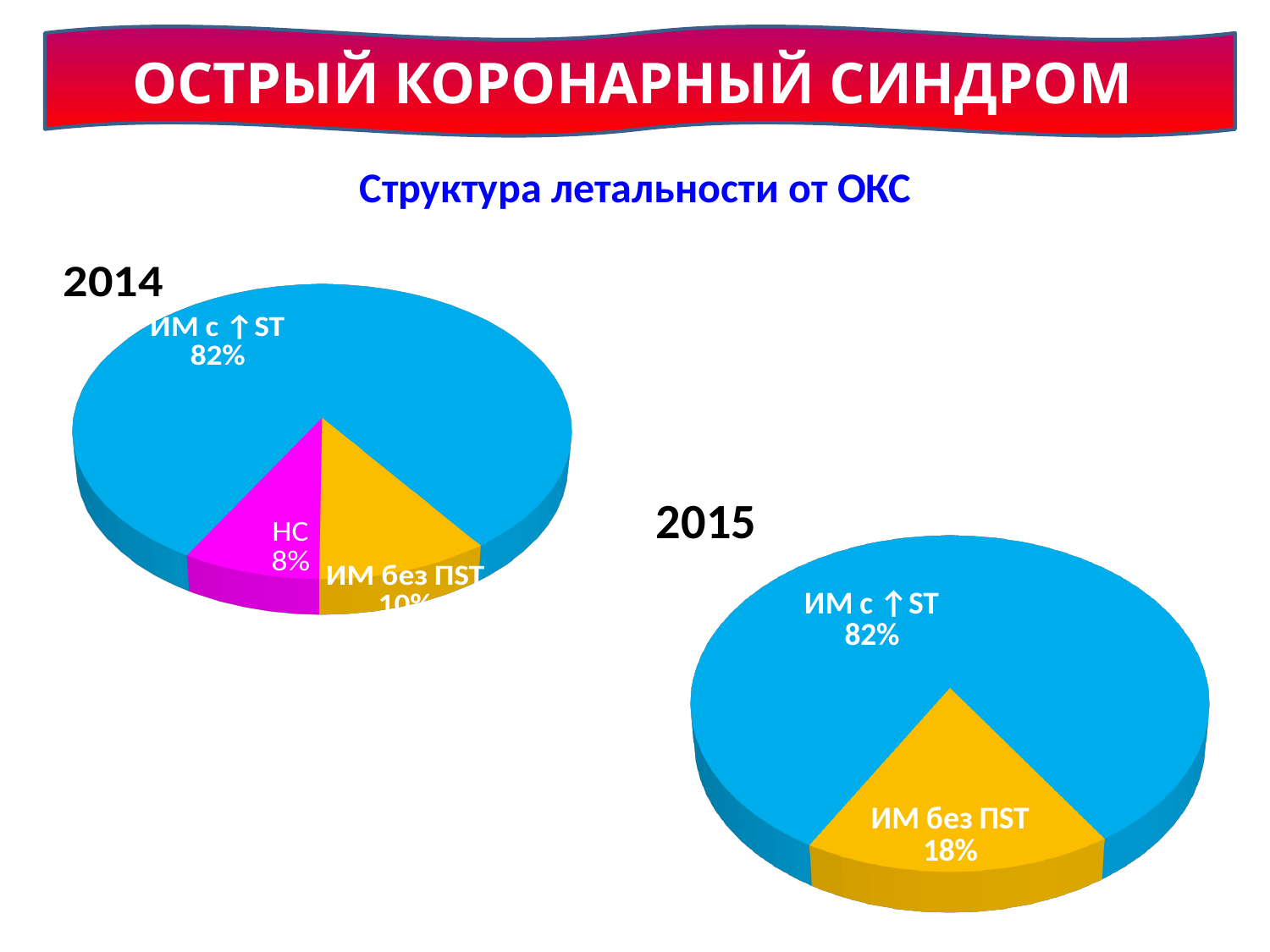
In the 2014 pie chart, which category has the largest slice? ИМ с ↑ST How many slices does the 2014 pie chart have? 3 What type of charts are shown on the slide? Pie charts What is the subtitle above the two pie charts? Структура летальности от ОКС In the 2015 pie chart, what share is labelled for ИМ с ↑ST? 82% In the 2015 pie chart, what share is labelled for ИМ без ПST? 18% How many slices does the 2015 pie chart have? 2 In the 2014 pie chart, what share is labelled for ИМ с ↑ST? 82% In the 2015 pie chart, which category has the smallest slice? ИМ без ПST In the 2014 pie chart, which category has the smallest slice? НС In the 2015 pie chart, what is the difference between the shares of ИМ с ↑ST and ИМ без ПST? 64%